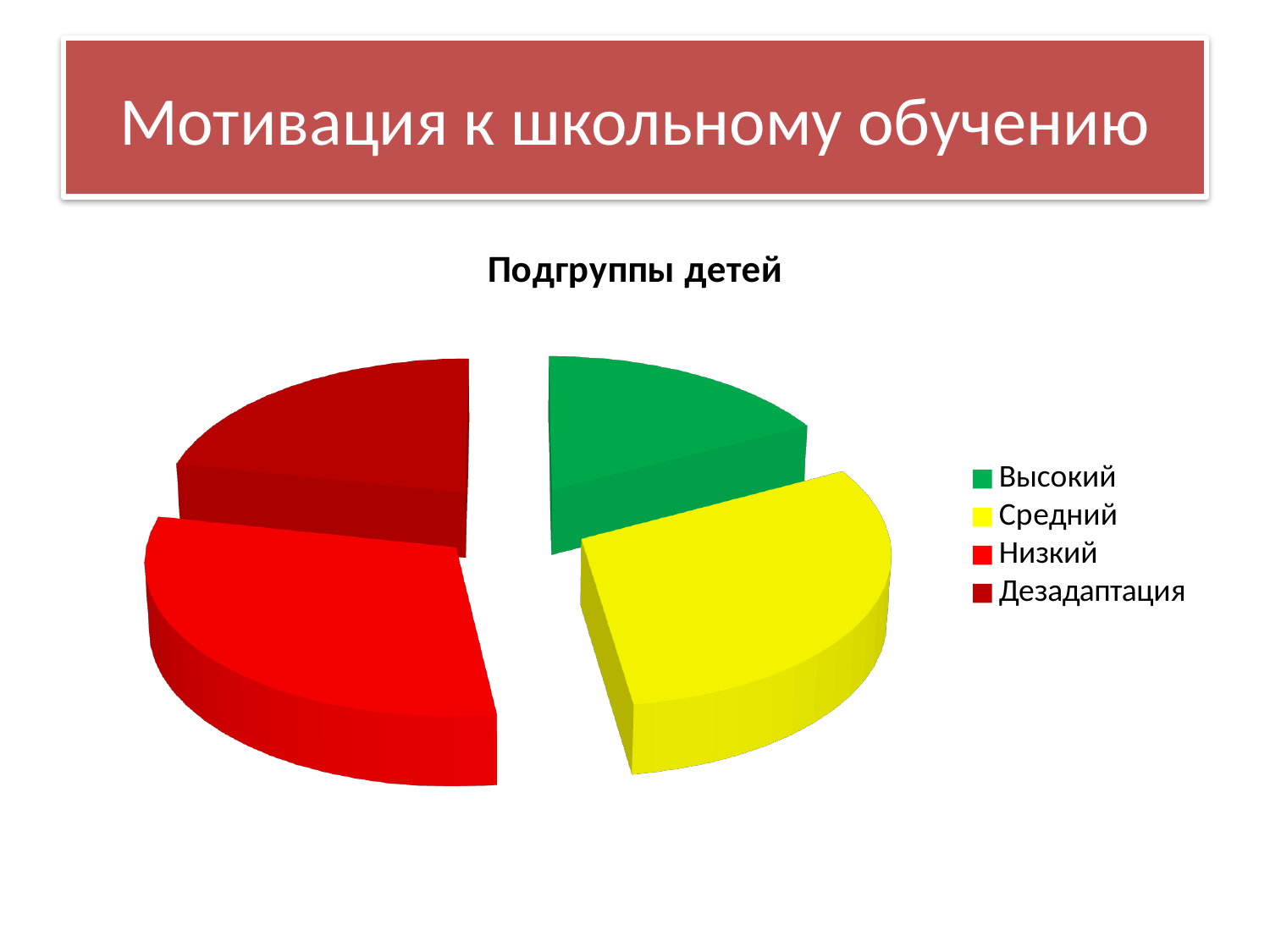
Which category has the smallest slice of the pie? Высокий How many entries does the legend list? 4 What is the title of the chart? Подгруппы детей How many slices does the pie chart have? 4 Which slice is larger, Низкий or Дезадаптация? Низкий What colour is the slice for Дезадаптация? Dark red What kind of chart is shown on the slide? Pie chart Which slice is larger, Средний or Высокий? Средний